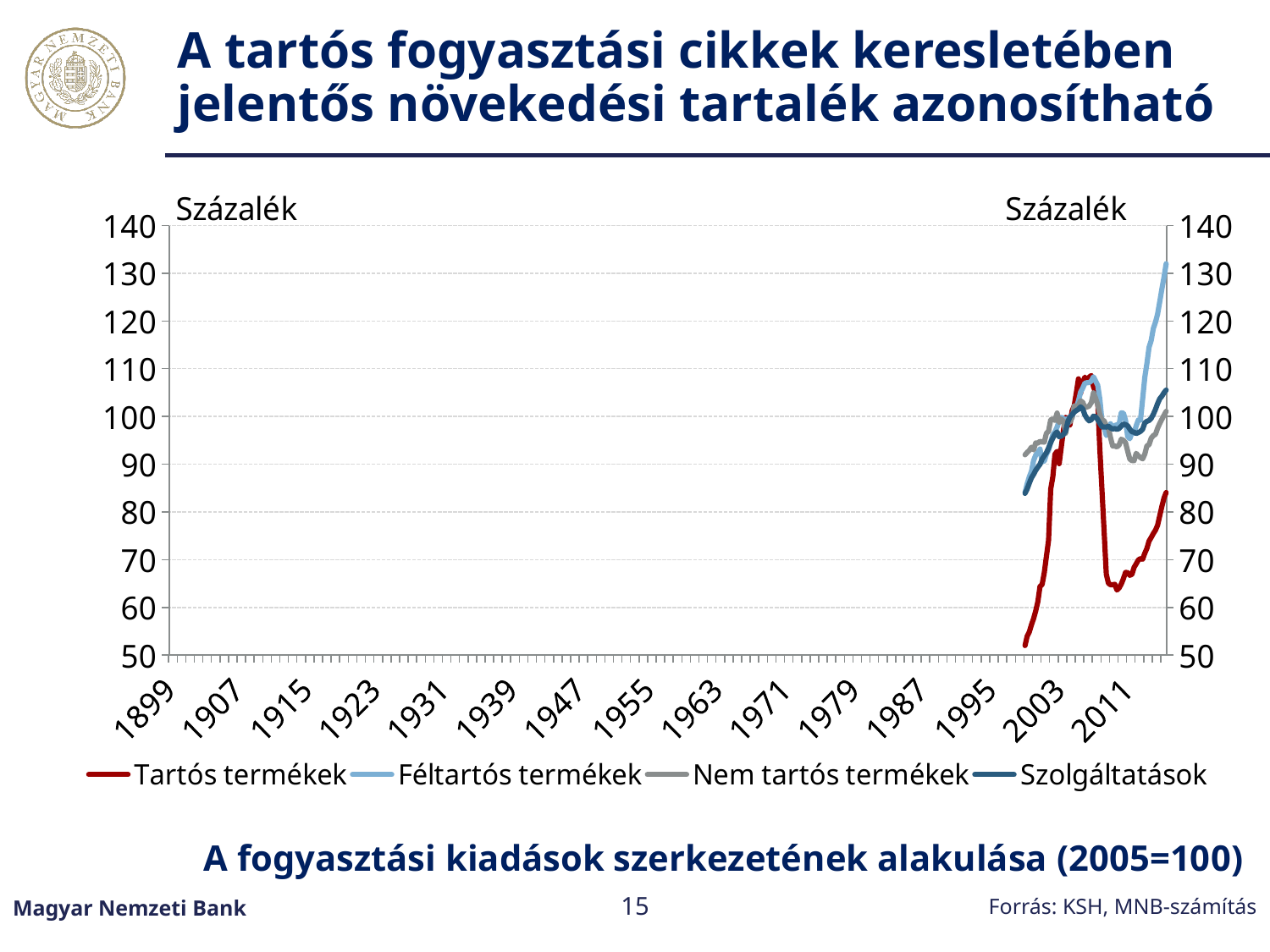
Is the final value of Féltartós termékek greater or less than 120? greater At the right end of the chart, which is larger: Féltartós termékek or Szolgáltatások? Féltartós termékek What kind of chart is shown on the slide? line chart What is the title of the chart shown below the plot? A fogyasztási kiadások szerkezetének alakulása (2005=100) What unit label is shown at the top of the vertical axes? Százalék How many series does the legend list? 4 Is the lowest value of Tartós termékek greater or less than 60? less What is the maximum value shown on the vertical axis? 140 Does the Féltartós termékek series rise or fall over the last few years shown? rise Which series reaches the highest value at the right end of the chart? Féltartós termékek Which series has the lowest value at the right end of the chart? Tartós termékek Is the final value of Tartós termékek greater or less than 90? less